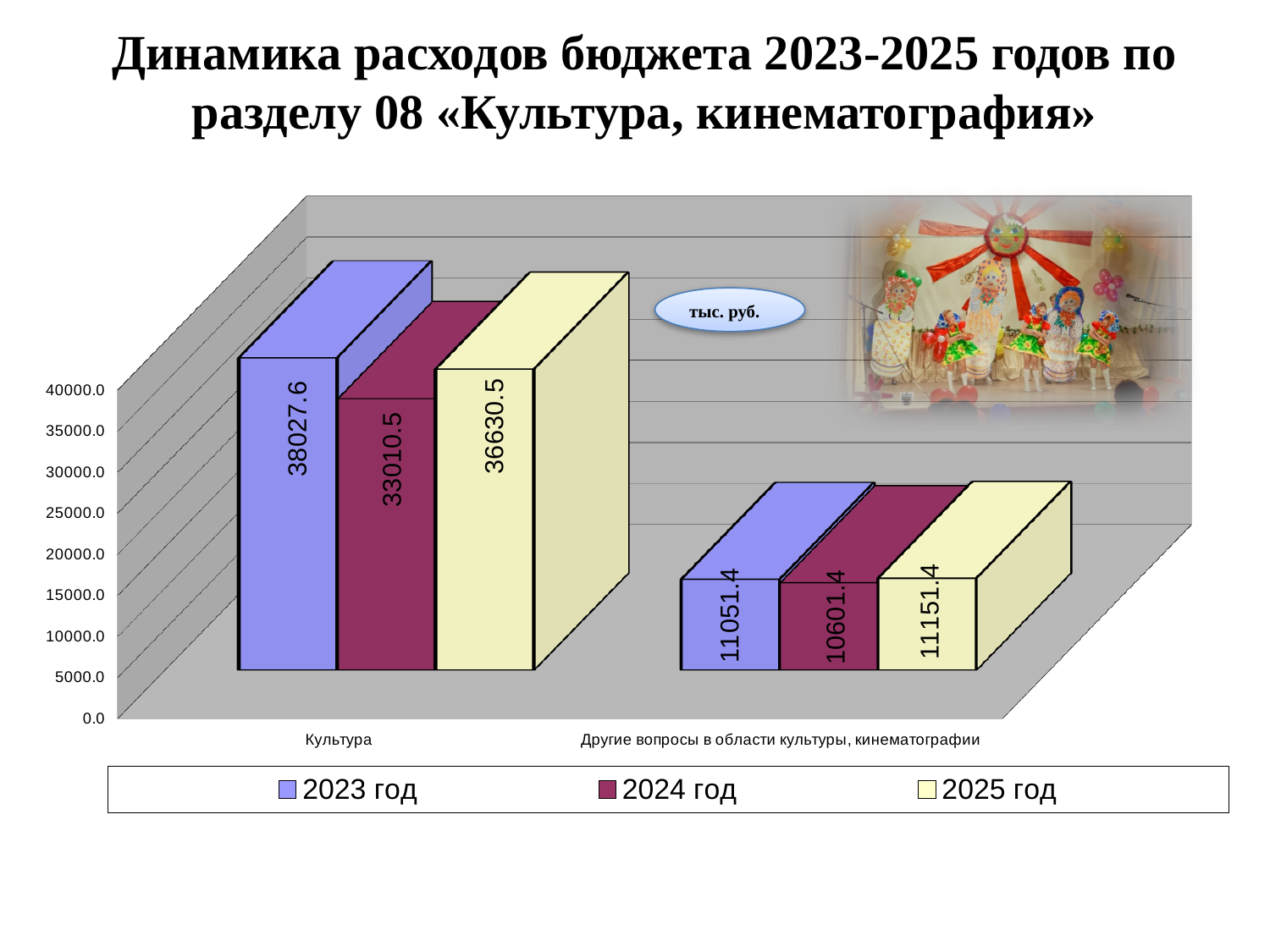
Which year has the highest value for Культура? 2023 год How many series does the legend list? 3 What is the difference between the 2025 год and 2024 год values for Другие вопросы в области культуры, кинематографии? 550.0 What is the value for Культура in 2023 год? 38027.6 What kind of chart is shown on the slide? Bar chart What is the difference between the 2023 год and 2024 год values for Культура? 5017.1 Which is larger: the 2025 год value for Культура or the 2024 год value for Культура? 2025 год What unit is indicated in the callout on the chart? тыс. руб. Which year has the lowest value for Другие вопросы в области культуры, кинематографии? 2024 год What is the value for Другие вопросы в области культуры, кинематографии in 2025 год? 11151.4 What is the value for Другие вопросы в области культуры, кинематографии in 2024 год? 10601.4 What is the value for Культура in 2024 год? 33010.5